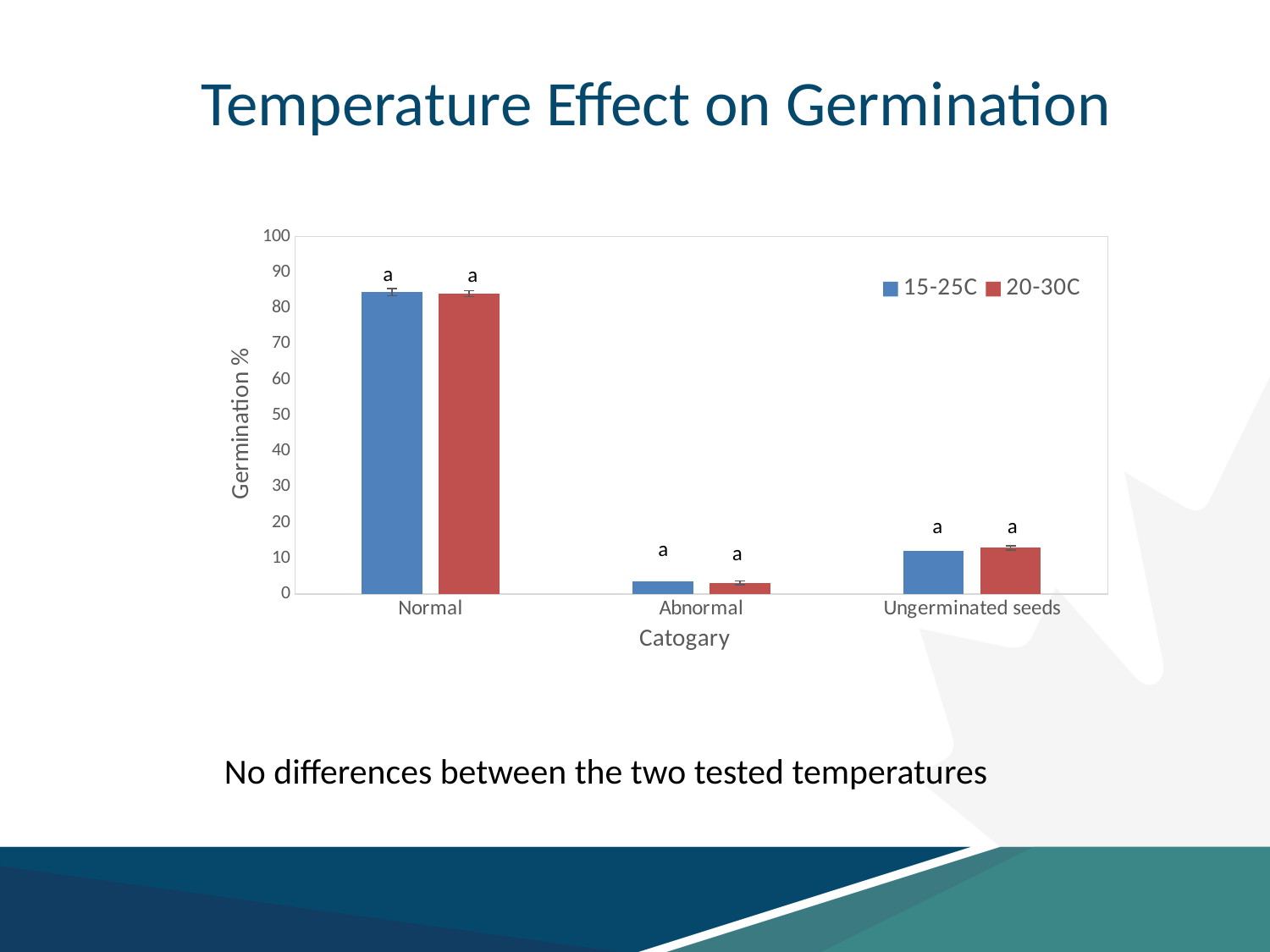
What kind of chart is shown on the slide? bar chart What is the label of the y axis? Germination % Is the value for Normal in the 15-25C series greater or less than 80? greater How many series does the legend list? 2 Is the value for Abnormal in the 20-30C series greater or less than 10? less How many categories are shown on the x axis? 3 Which is larger for the 15-25C series: Normal or Ungerminated seeds? Normal What is the title of the chart? Temperature Effect on Germination Which category has the lowest value for the 20-30C series? Abnormal Is the value for Ungerminated seeds in the 15-25C series greater or less than 20? less Which category has the highest value for the 15-25C series? Normal